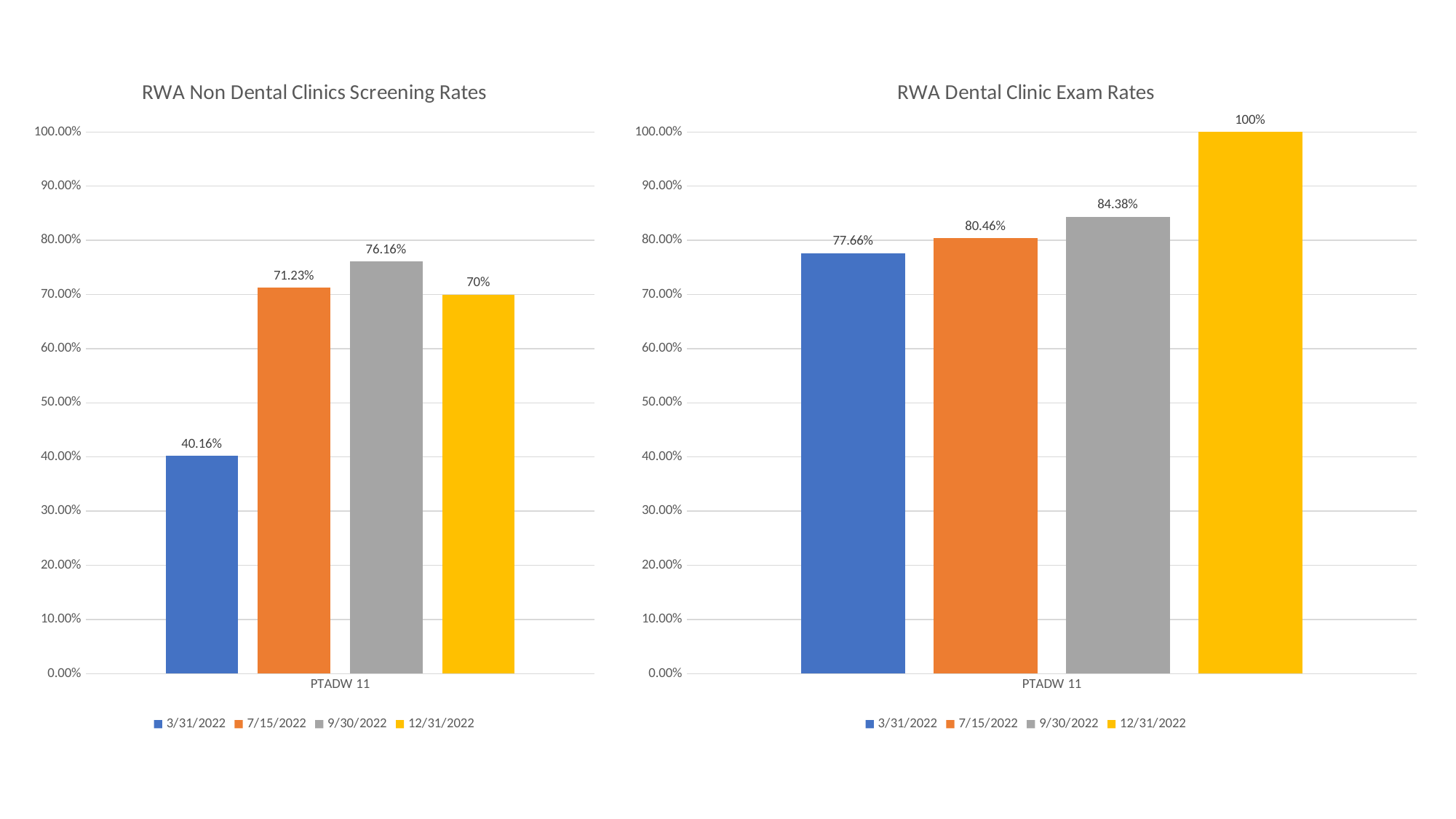
In the RWA Non Dental Clinics Screening Rates chart, what is the difference between the 7/15/2022 value and the 3/31/2022 value? 31.07% In the RWA Dental Clinic Exam Rates chart, is the value for 7/15/2022 greater or less than 70.00%? greater In the RWA Non Dental Clinics Screening Rates chart, which series has the highest value? 9/30/2022 In the RWA Non Dental Clinics Screening Rates chart, what is the value for 3/31/2022? 40.16% In the RWA Dental Clinic Exam Rates chart, what is the value for 9/30/2022? 84.38% In the RWA Non Dental Clinics Screening Rates chart, which is larger, the value for 7/15/2022 or the value for 12/31/2022? 7/15/2022 In the RWA Dental Clinic Exam Rates chart, do the values rise or fall from 3/31/2022 to 12/31/2022? rise What kind of chart is the RWA Non Dental Clinics Screening Rates chart? bar chart In the RWA Dental Clinic Exam Rates chart, what is the difference between the 12/31/2022 value and the 3/31/2022 value? 22.34% In the RWA Dental Clinic Exam Rates chart, which series has the highest value? 12/31/2022 How many series does the legend of the RWA Dental Clinic Exam Rates chart list? 4 In the RWA Non Dental Clinics Screening Rates chart, which series has the lowest value? 3/31/2022